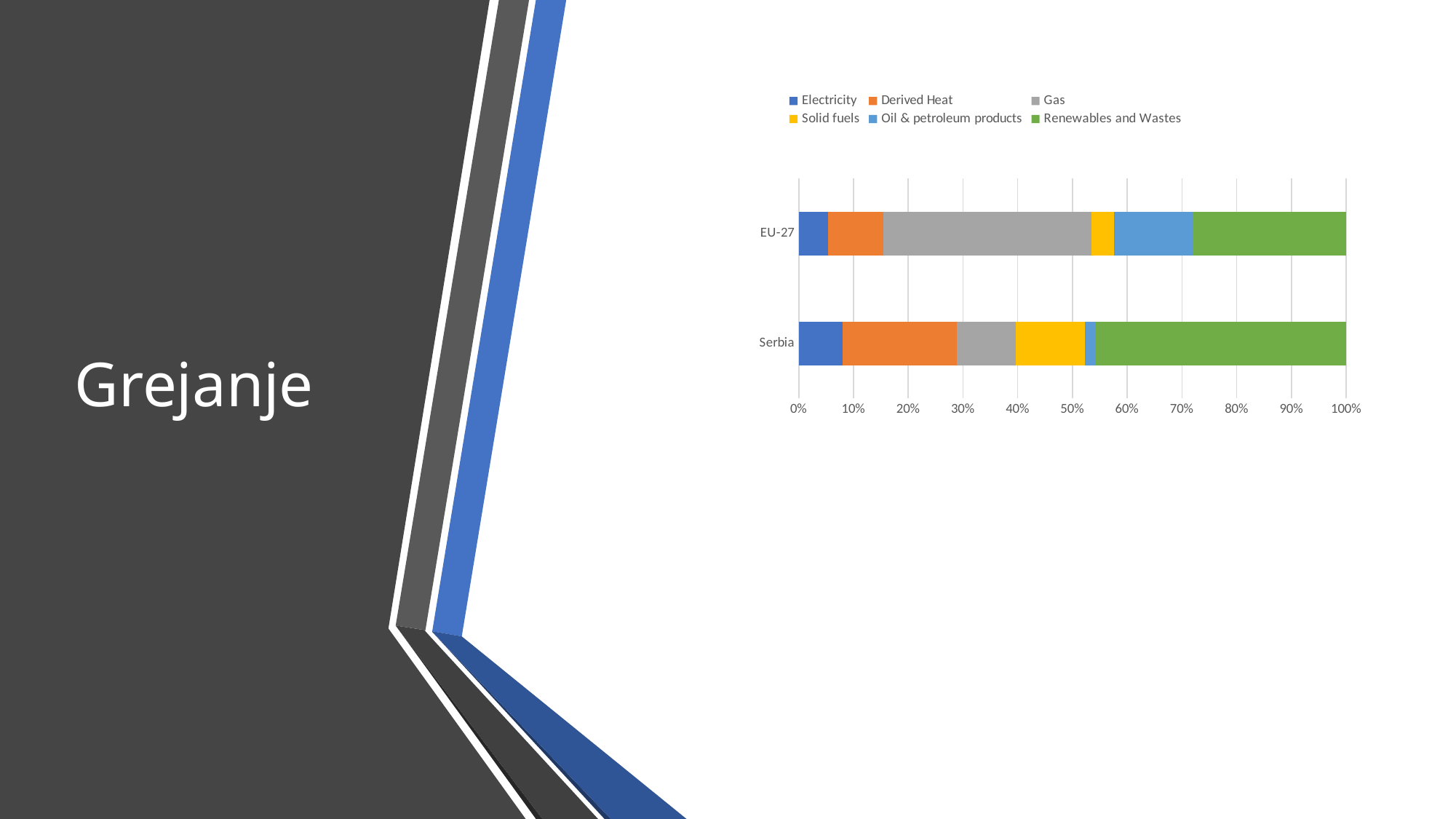
Is the Gas share for EU-27 greater or less than 30%? greater Which has a larger Gas share, EU-27 or Serbia? EU-27 Is the Oil & petroleum products share for Serbia greater or less than 10%? less Is the Renewables and Wastes share for Serbia greater or less than 40%? greater Which series makes up the smallest share of the Serbia bar? Oil & petroleum products Which series makes up the largest share of the EU-27 bar? Gas Which series is shown in green in the legend? Renewables and Wastes Which series makes up the largest share of the Serbia bar? Renewables and Wastes Which has a larger Derived Heat share, EU-27 or Serbia? Serbia How many series does the legend list? 6 What kind of chart is shown on the slide? Stacked bar chart How many categories (bars) does the chart show? 2